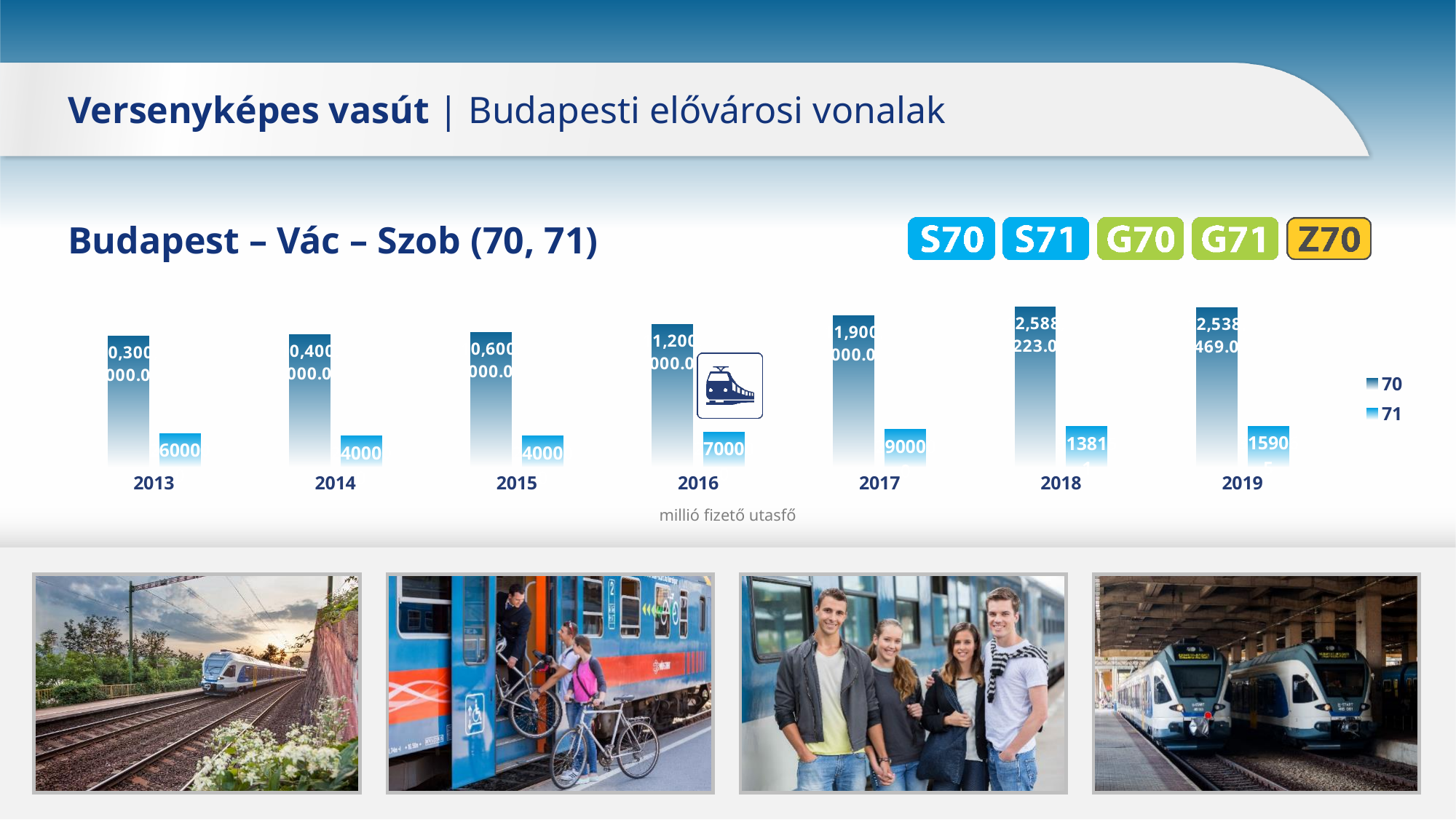
Does the value of series 70 generally rise or fall from 2013 to 2018? rise What kind of chart is shown on the slide? bar chart For series 71, which year has the larger value, 2014 or 2019? 2019 What are the two series named in the chart legend? 70 and 71 How many series does the chart legend list? 2 For series 70, which year has the larger value, 2015 or 2018? 2018 For series 70, which year has the larger value, 2013 or 2017? 2017 What is the first year shown on the chart's x axis? 2013 How many years are shown along the x axis of the chart? 7